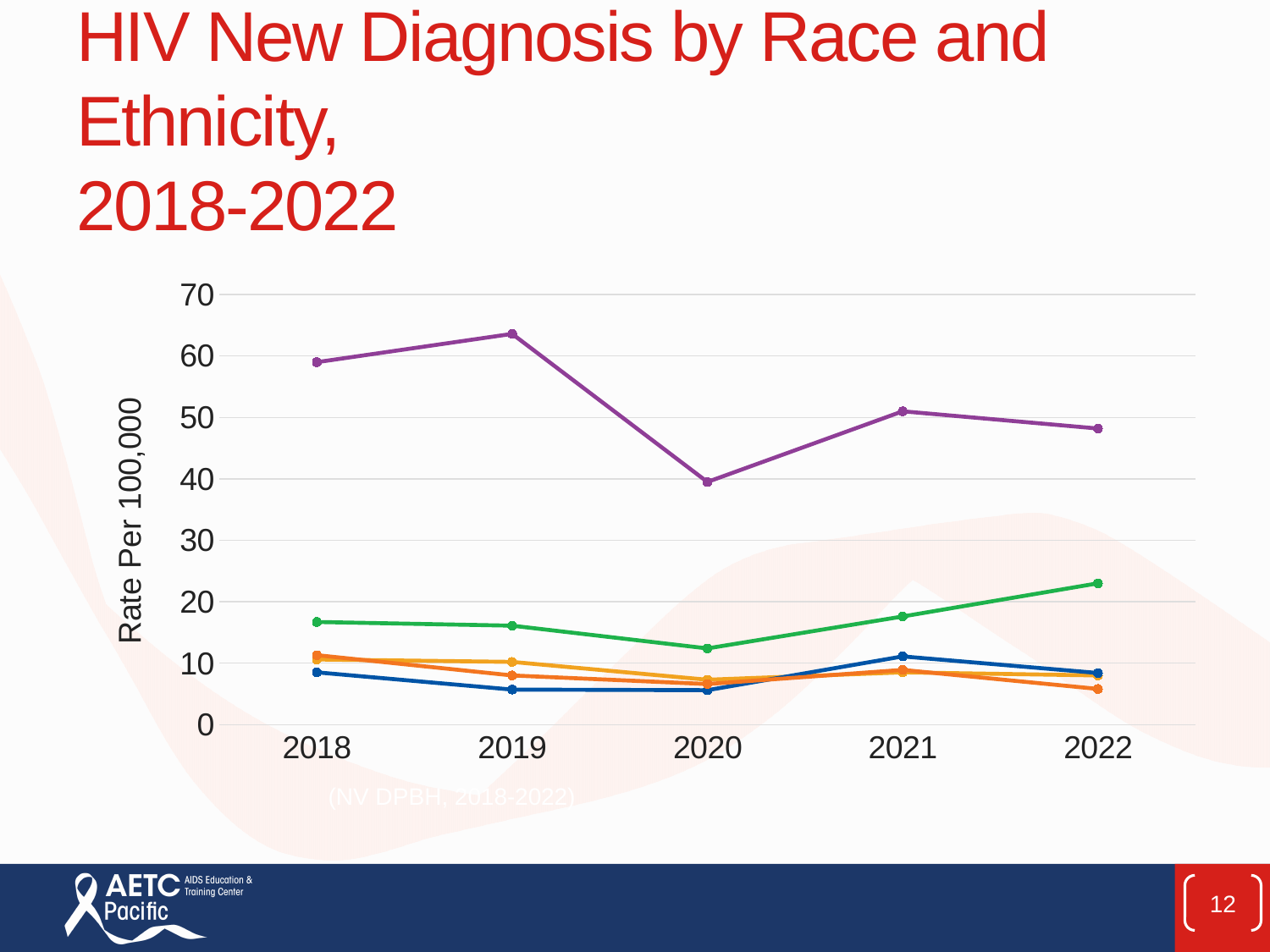
Does the green line rise or fall from 2020 to 2022? rise Is the value of the purple line in 2020 greater or less than 50? less How many years are shown on the x axis of the chart? 5 What is the label on the y axis of the chart? Rate Per 100,000 Is the value of the purple line in 2019 greater or less than 60? greater What kind of chart is shown on the slide? line chart In which year does the green line reach its highest value? 2022 Does the purple line rise or fall from 2019 to 2020? fall In 2020, which line has the higher value, the purple line or the green line? the purple line Is the value of the green line in 2022 greater or less than 20? greater In which year does the purple line reach its highest value? 2019 In which year does the purple line reach its lowest value? 2020